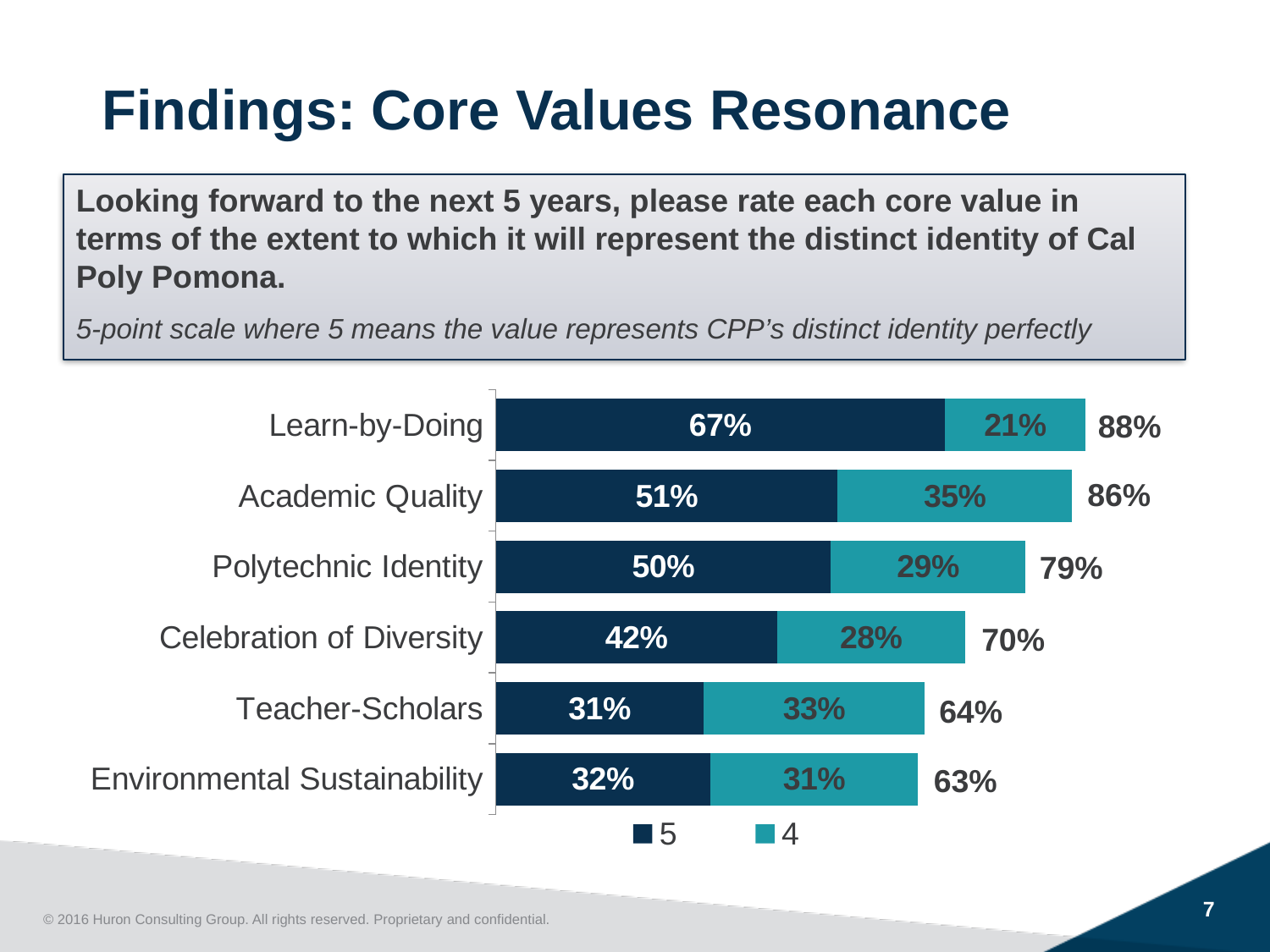
What kind of chart is shown on the slide? Stacked bar chart Which core value has the lowest combined total of 5 and 4 ratings? Environmental Sustainability What is the combined total (5 and 4 ratings) shown for Polytechnic Identity? 79% How many core values are shown in the chart? 6 What are the two legend entries in the chart? 5 and 4 Which core value has the highest percentage of 5 ratings? Learn-by-Doing What percentage of respondents rated Learn-by-Doing a 5? 67% What percentage of respondents rated Academic Quality a 4? 35% What is the combined total shown for Teacher-Scholars? 64% What is the difference between the 5 rating for Learn-by-Doing and the 5 rating for Academic Quality? 16% How many series does the legend list? 2 Which is larger: the 4 rating for Teacher-Scholars or the 4 rating for Celebration of Diversity? Teacher-Scholars